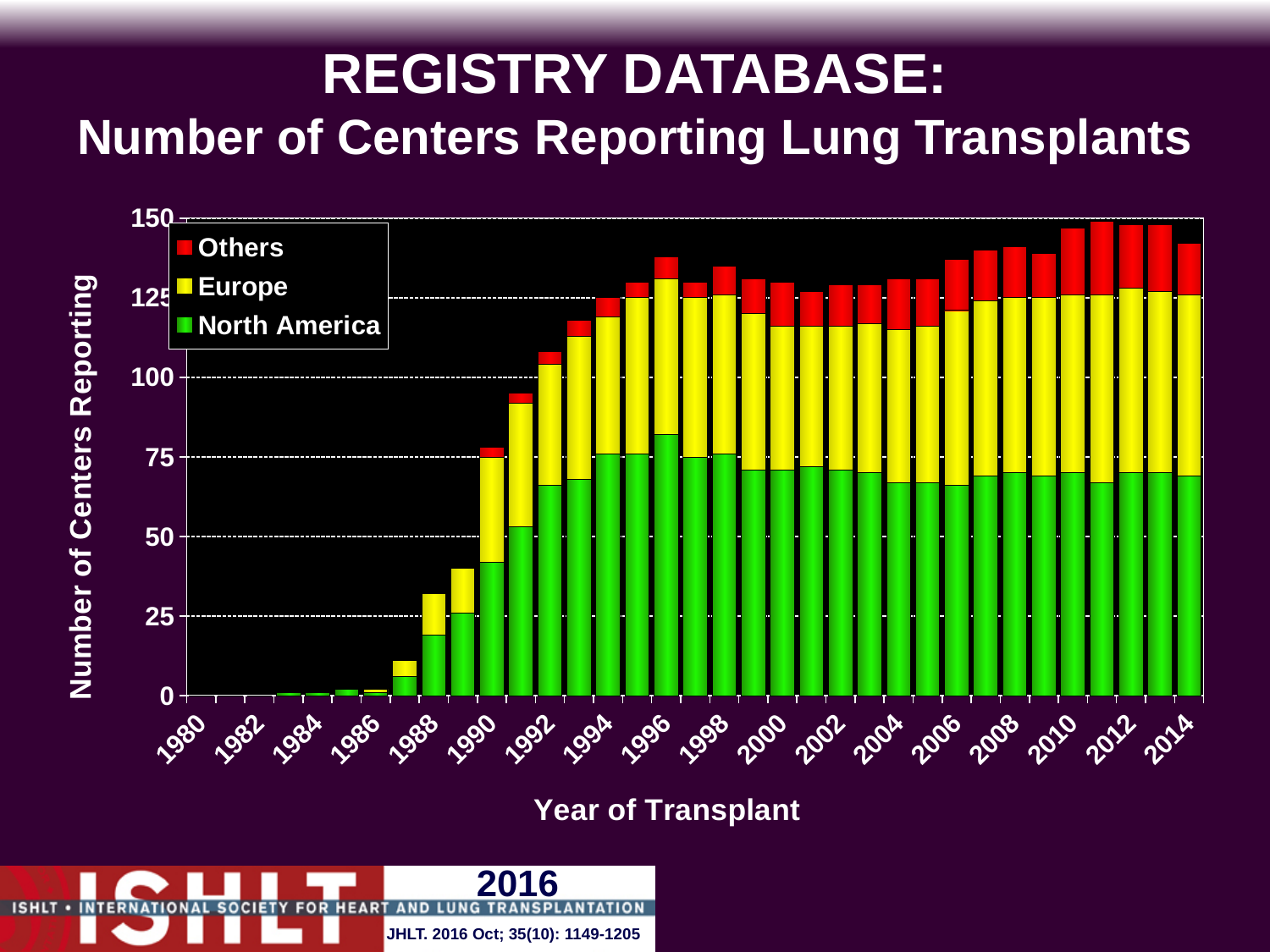
Is the total number of centers reporting in 1987 greater or less than 25? less What kind of chart is shown on the slide? Stacked bar chart Which year has a larger total number of centers reporting, 1990 or 1996? 1996 Do the total numbers of centers reporting rise or fall from 1986 to 1996? rise Is the total number of centers reporting in 1988 greater or less than 25? greater Which series is shown in green in the chart? North America Is the total number of centers reporting in 1996 greater or less than 125? greater What is the label of the y axis? Number of Centers Reporting How many years are labeled on the x axis? 18 How many series does the legend list? 3